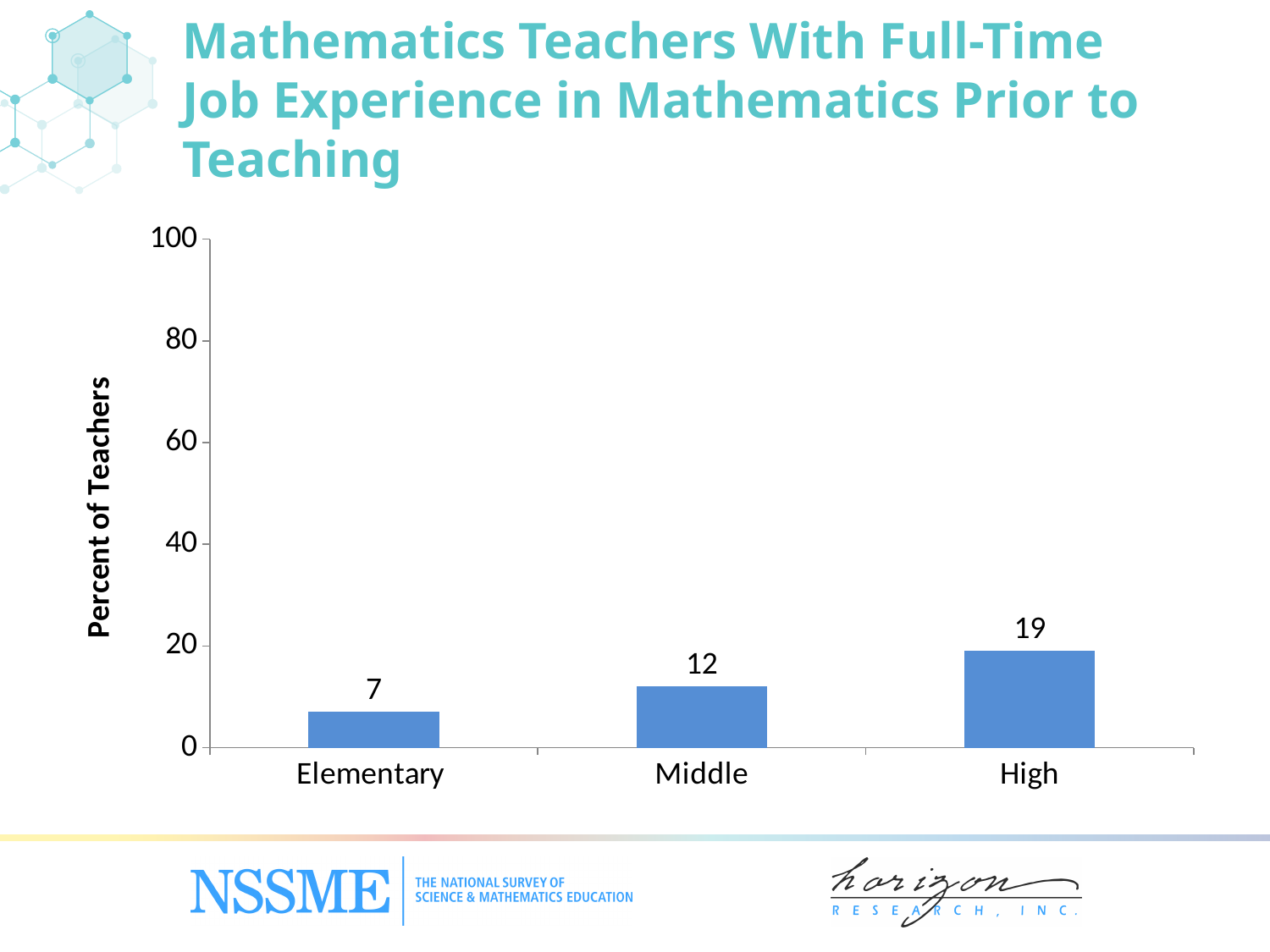
What is the label of the y axis? Percent of Teachers Which category has the lowest value? Elementary How many categories are shown on the x axis? 3 Is the value for High greater or less than 20? less What is the value for Elementary? 7 What kind of chart is shown on the slide? bar chart What is the value for High? 19 Which category has the highest value? High What is the difference between the values for High and Elementary? 12 What is the difference between the values for Middle and Elementary? 5 Which is larger, the value for Middle or the value for High? High What is the value for Middle? 12